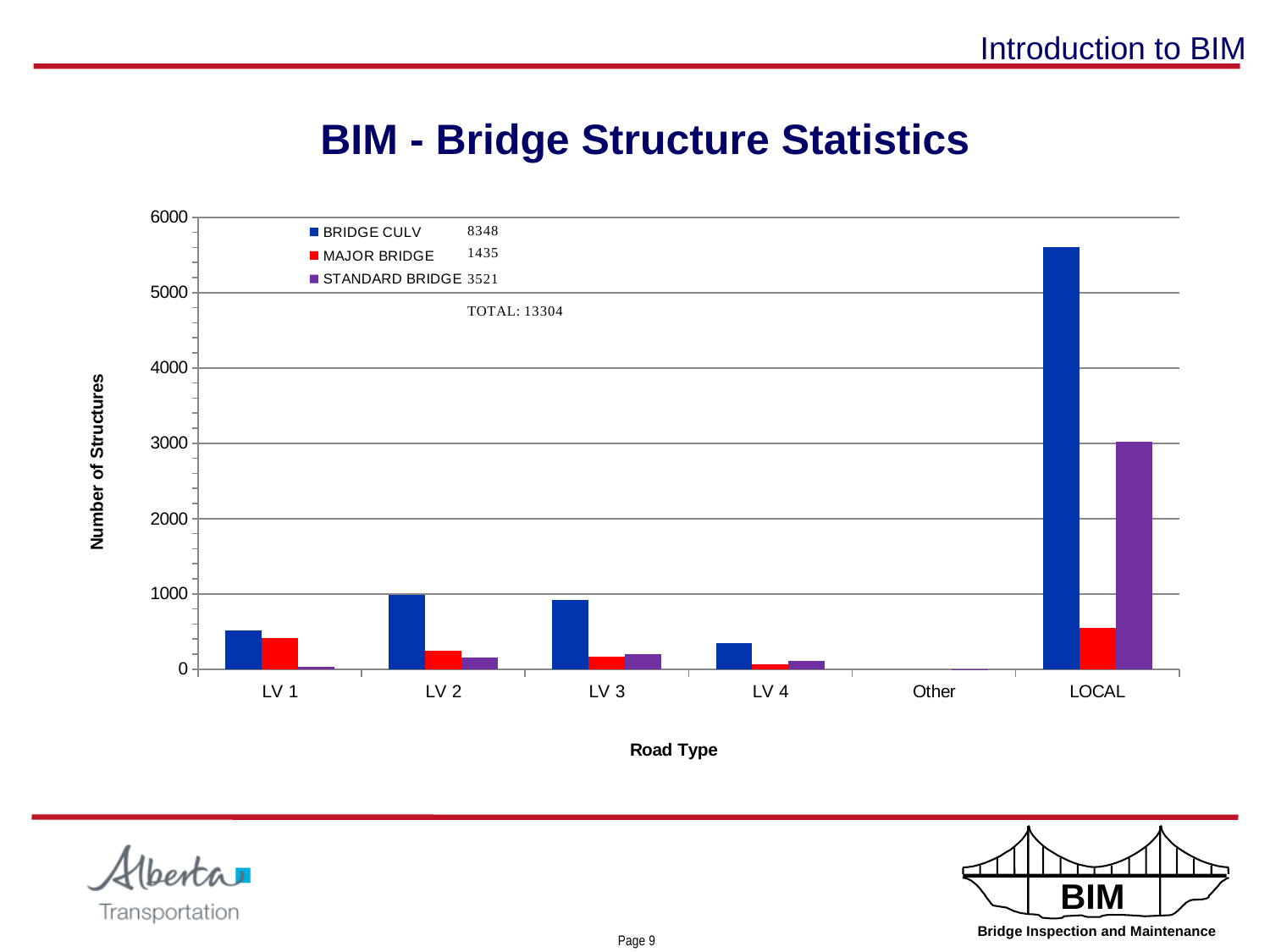
What kind of chart is shown on the slide? bar chart Which is larger, the BRIDGE CULV value for LV 2 or for LV 1? LV 2 How many road type categories are shown on the x axis? 6 Which is larger, the MAJOR BRIDGE value for LV 1 or the STANDARD BRIDGE value for LV 1? MAJOR BRIDGE How many series does the legend list? 3 Which road type has the highest number of STANDARD BRIDGE structures? LOCAL What total is printed next to BRIDGE CULV in the legend? 8348 What is the TOTAL printed below the legend? 13304 Is the BRIDGE CULV value for LOCAL greater or less than 5000? greater Which road type has the highest number of BRIDGE CULV structures? LOCAL Is the STANDARD BRIDGE value for LOCAL greater or less than 2000? greater